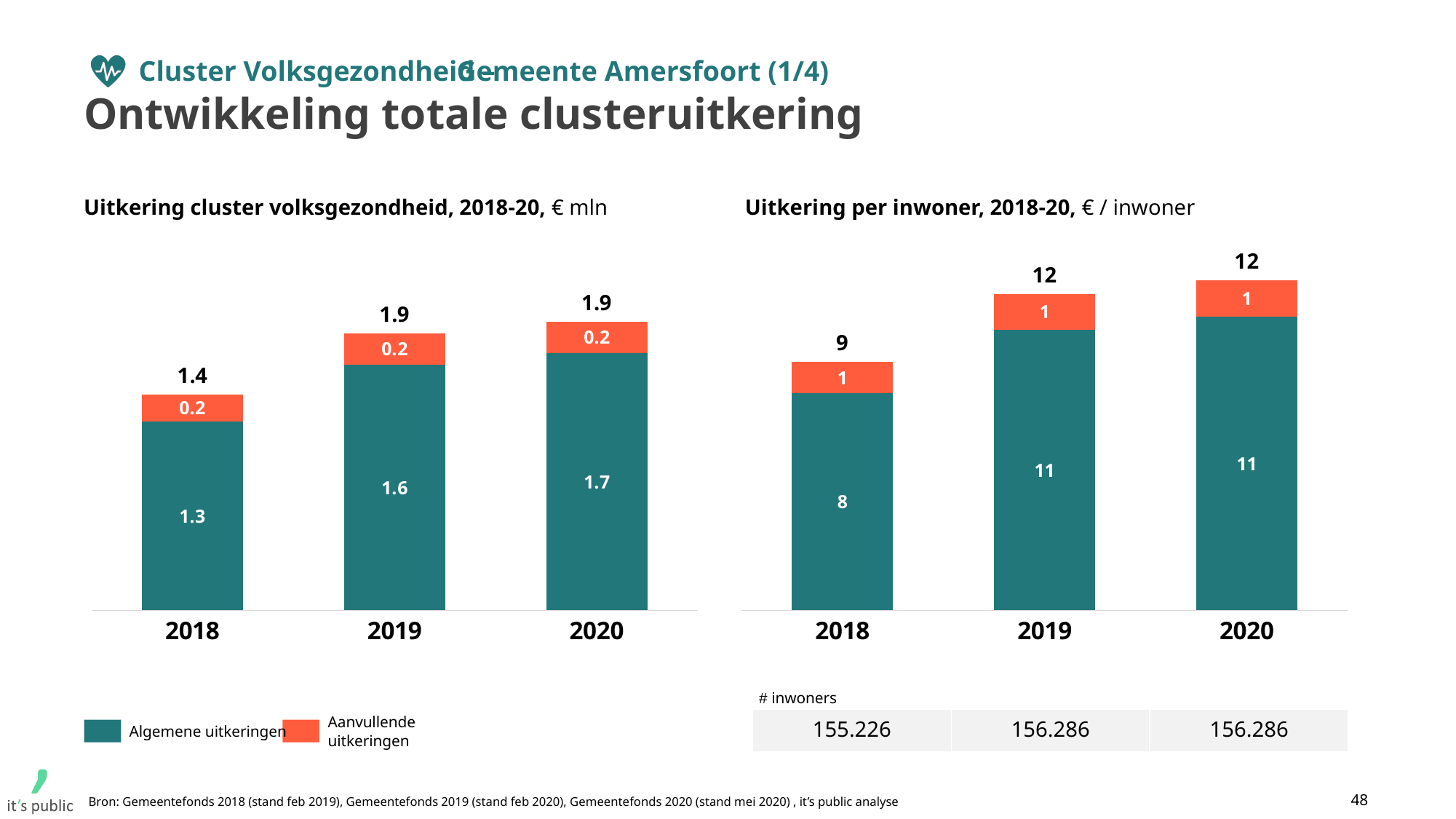
In the left chart (Uitkering cluster volksgezondheid), which year has the lowest total? 2018 In the right chart (Uitkering per inwoner), what is the total of the stacked bar for 2020? 12 In the left chart (Uitkering cluster volksgezondheid), what is the total of the stacked bar for 2019? 1.9 How many years are shown on the x axis of the left chart (Uitkering cluster volksgezondheid)? 3 In the left chart (Uitkering cluster volksgezondheid), what is the value of Algemene uitkeringen for 2018? 1.3 In the right chart (Uitkering per inwoner), is the total for 2018 larger or smaller than the total for 2019? smaller In the right chart (Uitkering per inwoner), what is the value of Algemene uitkeringen for 2018? 8 In the right chart (Uitkering per inwoner), what is the difference in Algemene uitkeringen between 2019 and 2018? 3 What type of chart is the right chart (Uitkering per inwoner)? Stacked bar chart In the left chart (Uitkering cluster volksgezondheid), what is the value of Aanvullende uitkeringen for 2020? 0.2 In the left chart (Uitkering cluster volksgezondheid), what is the difference in Algemene uitkeringen between 2019 and 2018? 0.3 How many series does the legend list for the charts? 2